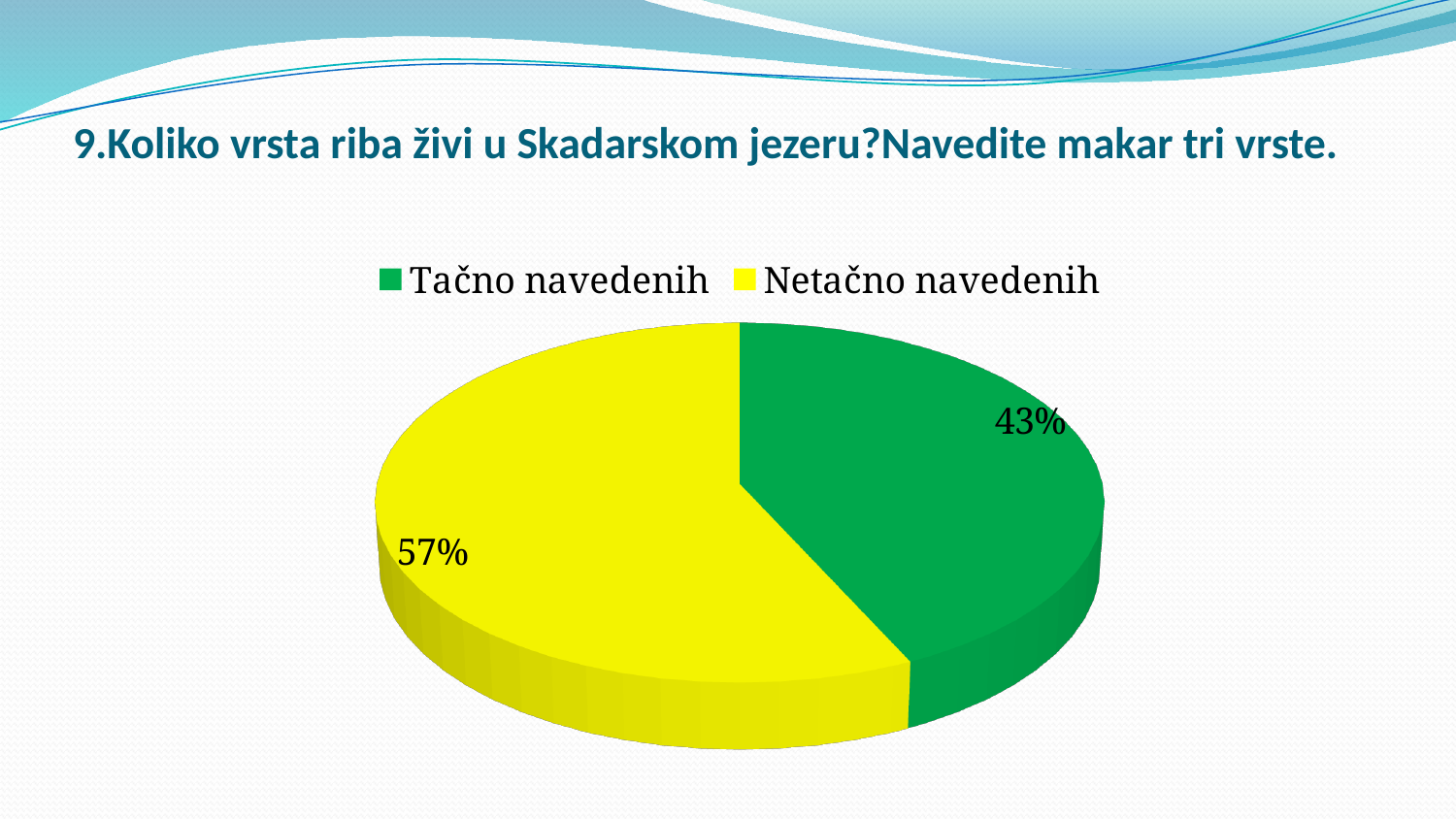
What share of the pie is labelled "Netačno navedenih"? 57% What colour is the "Tačno navedenih" slice? Green Which slice of the pie is the smallest? Tačno navedenih What colour is the "Netačno navedenih" slice? Yellow What is the difference in percentage points between the "Netačno navedenih" and "Tačno navedenih" slices? 14 How many slices does the pie chart have? 2 What share of the pie is labelled "Tačno navedenih"? 43% What kind of chart is shown on the slide? Pie chart How many entries does the legend list? 2 Which slice of the pie is the largest? Netačno navedenih Which is larger, the "Tačno navedenih" slice or the "Netačno navedenih" slice? Netačno navedenih Is the "Tačno navedenih" slice more or less than half of the pie? less